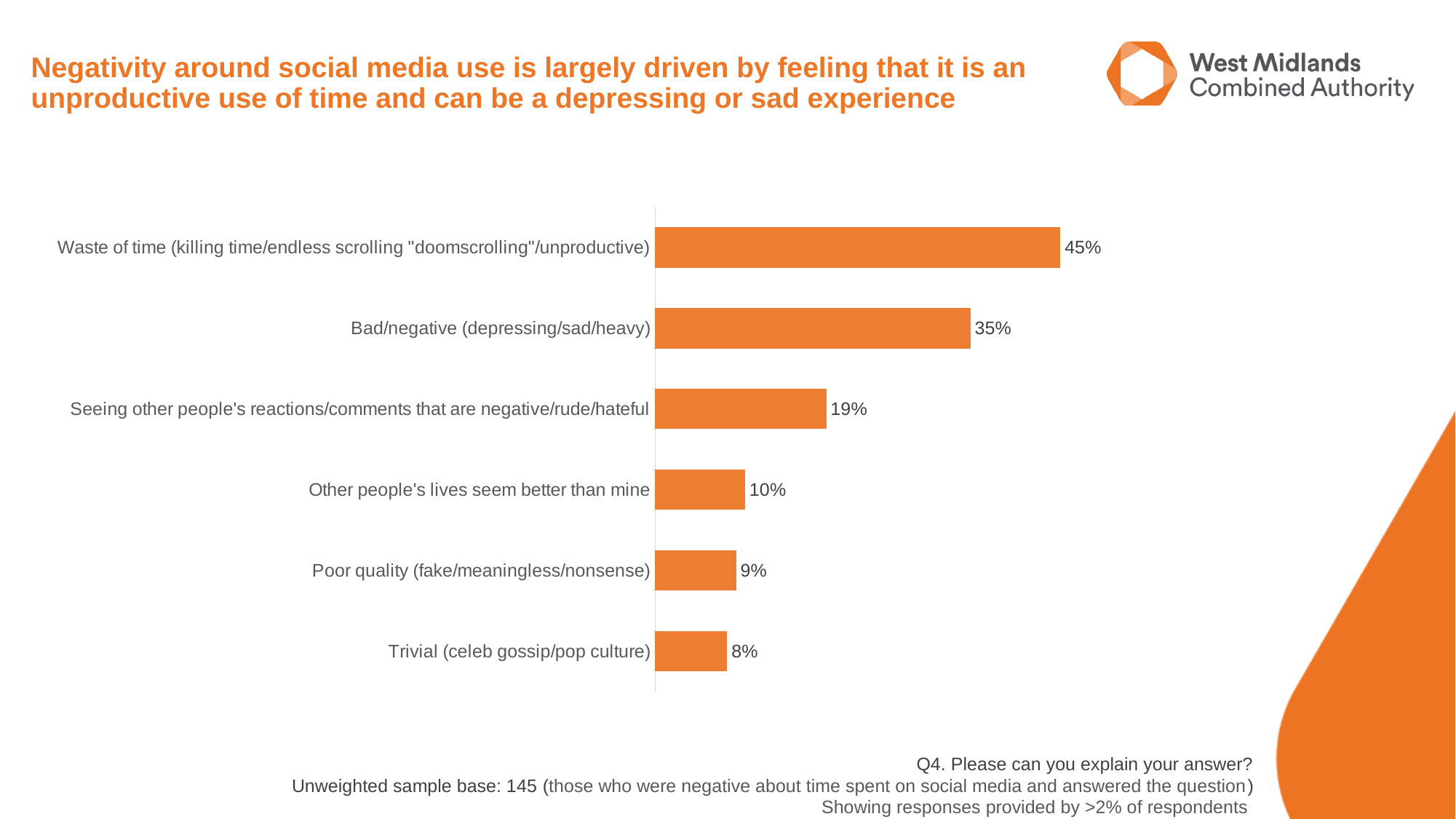
What percentage is shown for "Seeing other people's reactions/comments that are negative/rude/hateful"? 19% What is the value for "Bad/negative (depressing/sad/heavy)"? 35% What is the difference between "Other people's lives seem better than mine" and "Poor quality (fake/meaningless/nonsense)"? 1% Which category has the lowest value? Trivial (celeb gossip/pop culture) What is the difference between the values for "Waste of time" and "Bad/negative"? 10% What is the unweighted sample base stated below the chart? 145 What type of chart is shown on the slide? Bar chart Which category has the highest value? Waste of time (killing time/endless scrolling "doomscrolling"/unproductive) How many categories are shown in the chart? 6 What percentage of respondents cited "Waste of time (killing time/endless scrolling "doomscrolling"/unproductive)"? 45% Which is larger: the value for "Bad/negative (depressing/sad/heavy)" or for "Seeing other people's reactions/comments that are negative/rude/hateful"? Bad/negative (depressing/sad/heavy) What is the value for "Trivial (celeb gossip/pop culture)"? 8%